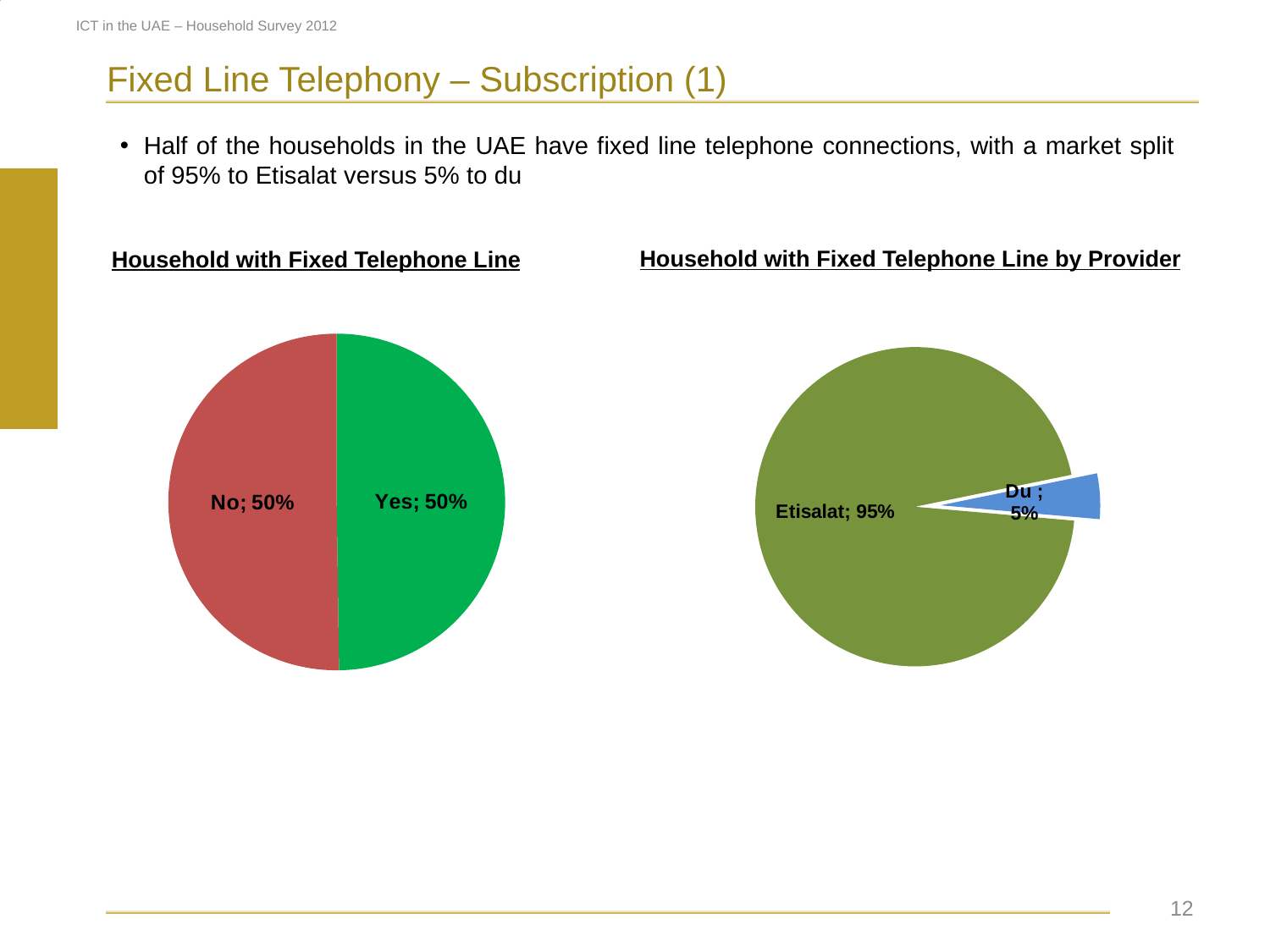
In the 'Household with Fixed Telephone Line by Provider' chart, which is larger, Etisalat or Du? Etisalat In the 'Household with Fixed Telephone Line by Provider' chart, what share is Du? 5% In the 'Household with Fixed Telephone Line' chart, what share of households answered No? 50% What kind of chart is 'Household with Fixed Telephone Line'? Pie chart In the 'Household with Fixed Telephone Line' chart, what colour is the Yes slice? Green In the 'Household with Fixed Telephone Line by Provider' chart, what is the difference between the Etisalat and Du shares? 90% How many charts are shown on the slide? 2 In the 'Household with Fixed Telephone Line by Provider' chart, what share is Etisalat? 95% In the 'Household with Fixed Telephone Line' chart, what share of households answered Yes? 50% How many slices does the 'Household with Fixed Telephone Line by Provider' chart have? 2 In the 'Household with Fixed Telephone Line by Provider' chart, which provider has the largest slice? Etisalat In the 'Household with Fixed Telephone Line by Provider' chart, which provider has the smallest slice? Du